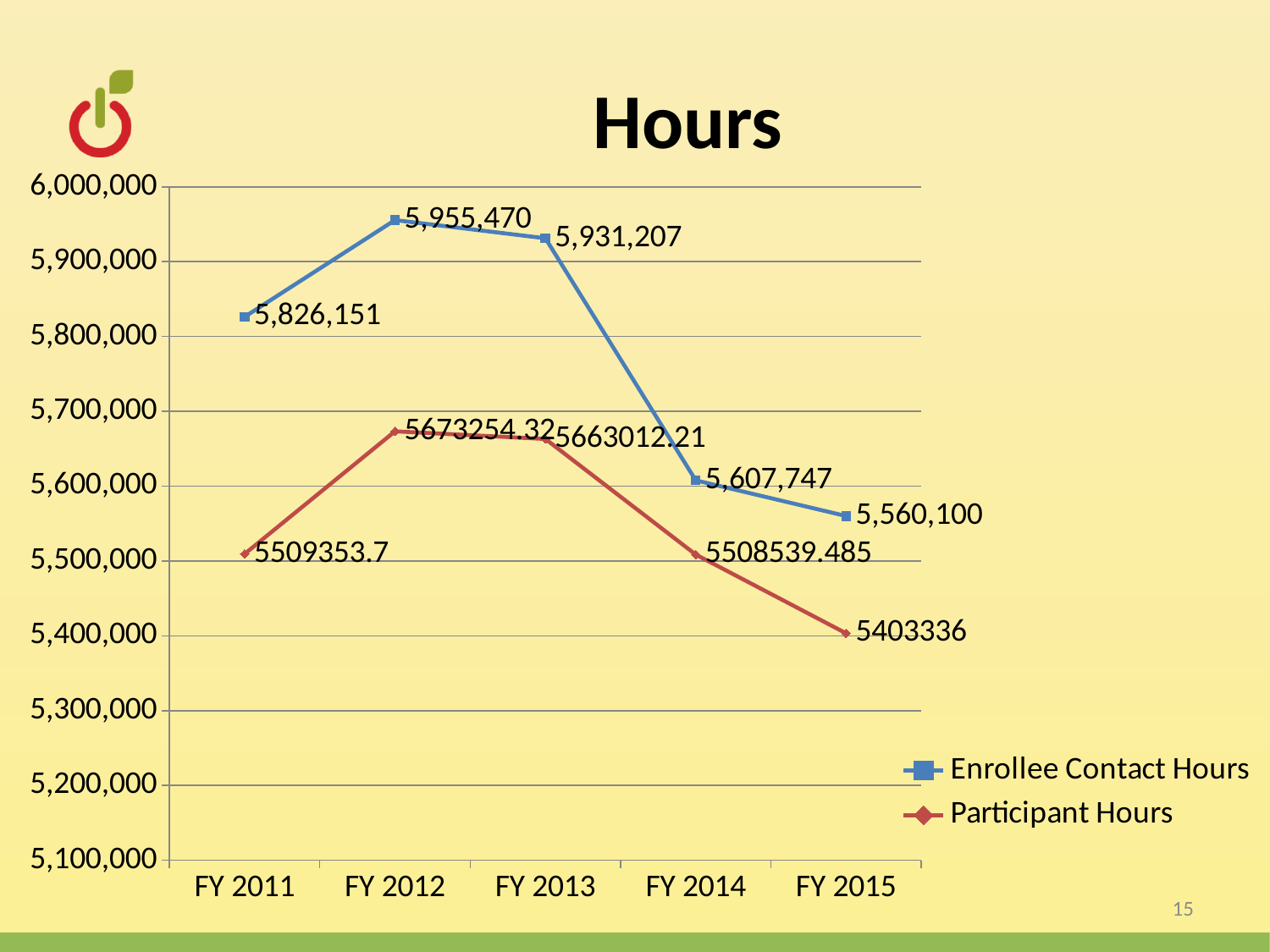
What is the value of Participant Hours for FY 2011? 5509353.7 How many series does the legend list? 2 In which fiscal year are Participant Hours lowest? FY 2015 What is the title of the chart? Hours What type of chart is shown on the slide? line chart What is the difference between Enrollee Contact Hours in FY 2012 and FY 2015? 395,370 What is the value of Participant Hours for FY 2015? 5403336 In which fiscal year are Enrollee Contact Hours highest? FY 2012 How many fiscal years are plotted on the x axis? 5 Do Enrollee Contact Hours rise or fall from FY 2013 to FY 2015? fall What is the value of Enrollee Contact Hours for FY 2012? 5,955,470 Which is larger in FY 2014: Enrollee Contact Hours or Participant Hours? Enrollee Contact Hours